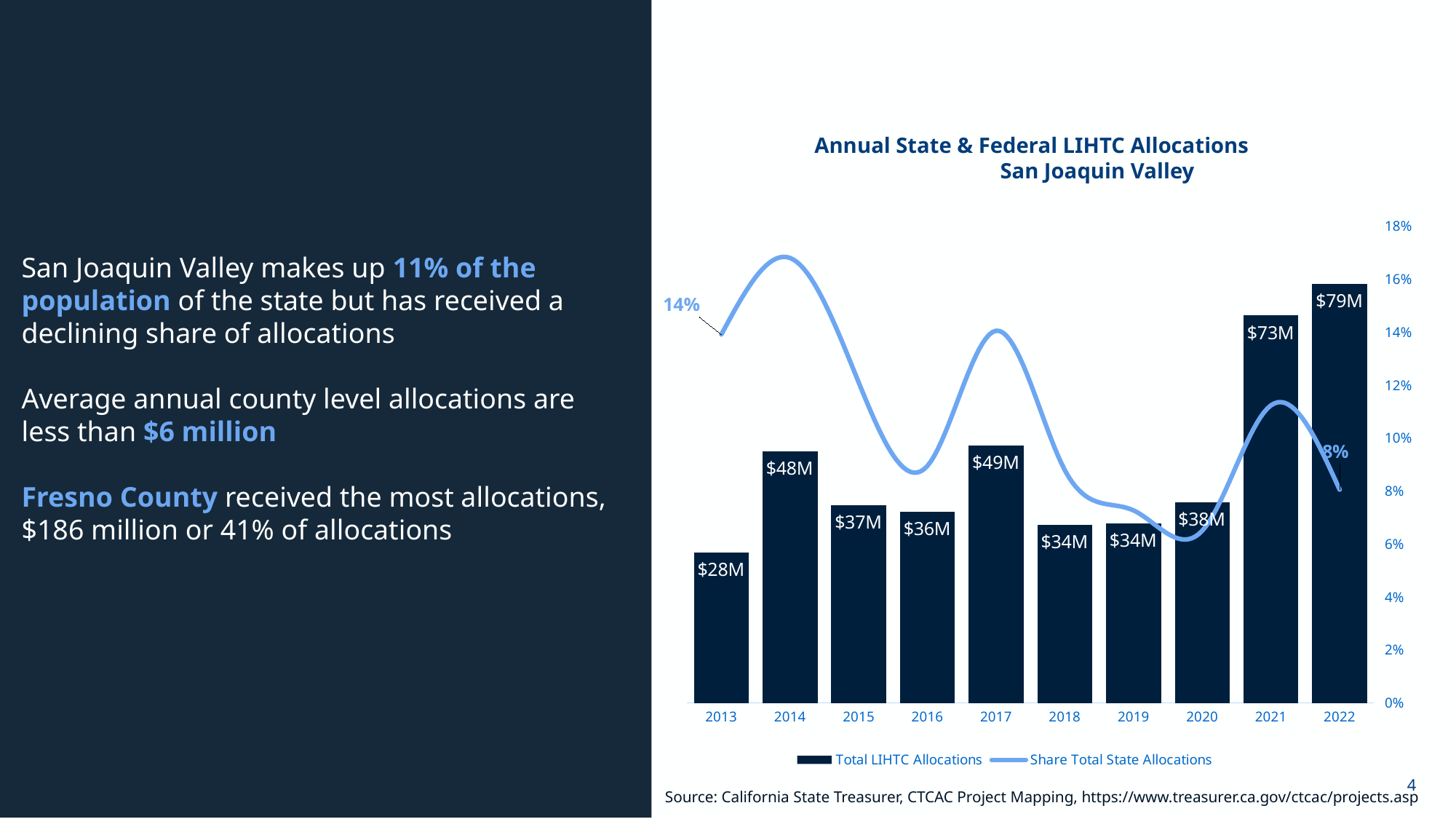
What is the Total LIHTC Allocations value for 2013? $28M What is the title of the chart? Annual State & Federal LIHTC Allocations San Joaquin Valley What is the Share Total State Allocations value labelled for 2013? 14% How many series does the legend list? 2 What is the Total LIHTC Allocations value for 2022? $79M What is the difference between the Total LIHTC Allocations for 2022 and 2021? $6M Which year has the lowest Total LIHTC Allocations? 2013 Is the Share Total State Allocations value for 2014 greater or less than 16%? greater Which year has the larger Total LIHTC Allocations, 2014 or 2017? 2017 Which year has the highest Total LIHTC Allocations? 2022 How many years are shown on the x axis? 10 What kind of chart is this? Combined bar and line chart